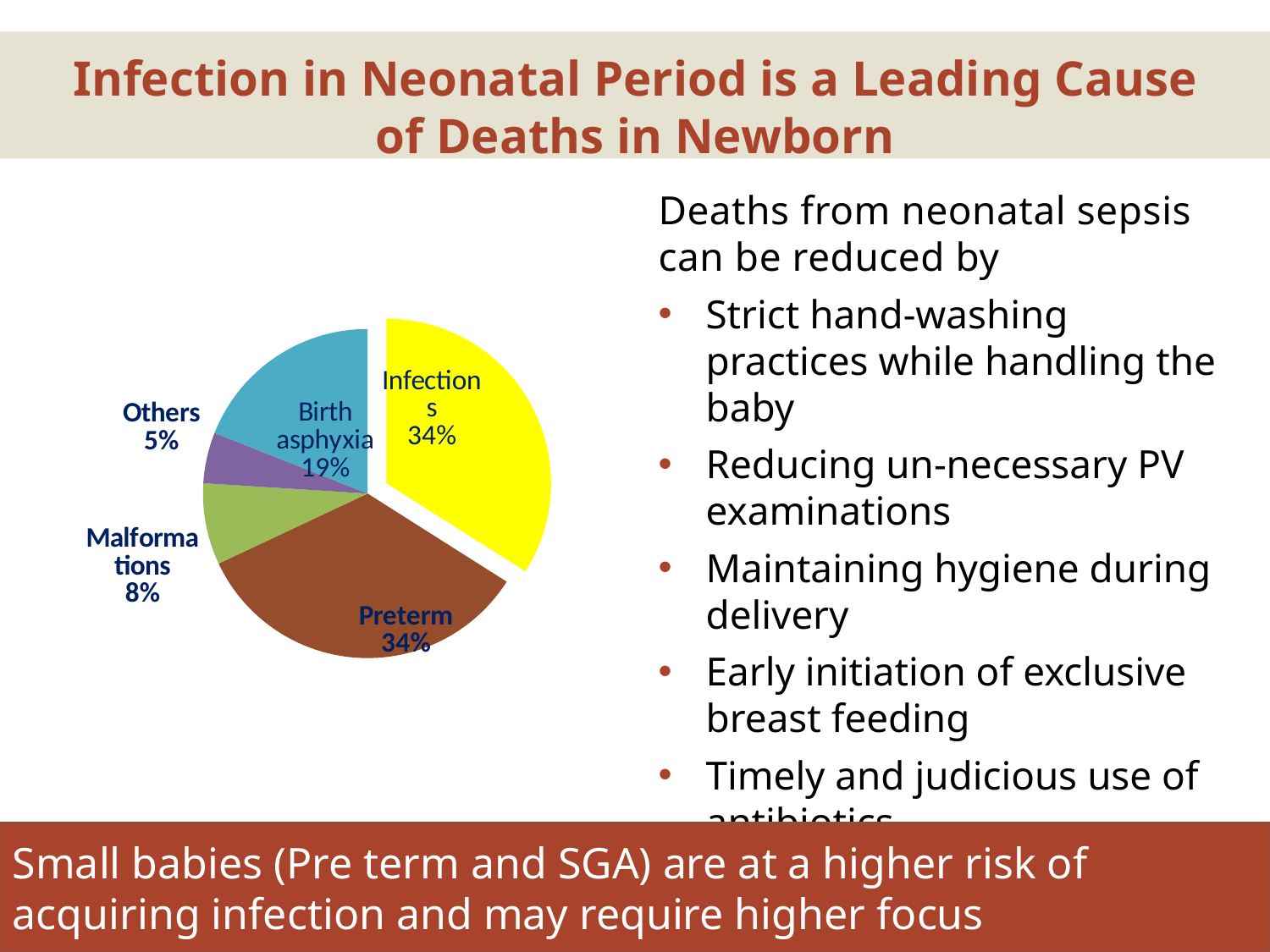
What kind of chart is shown on the slide? pie chart What is the value shown for Others in the pie chart? 5% Which category has the smallest slice in the pie chart? Others What is the value shown for Birth asphyxia in the pie chart? 19% What is the difference between the Malformations and Others values in the pie chart? 3% What is the difference between the Birth asphyxia and Malformations values in the pie chart? 11% What share of the pie does the Infections slice represent? 34% Which slice is pulled out (exploded) from the rest of the pie chart? Infections Which is larger in the pie chart, Birth asphyxia or Malformations? Birth asphyxia How many slices does the pie chart have? 5 What is the value shown for Malformations in the pie chart? 8% What is the value shown for Preterm in the pie chart? 34%